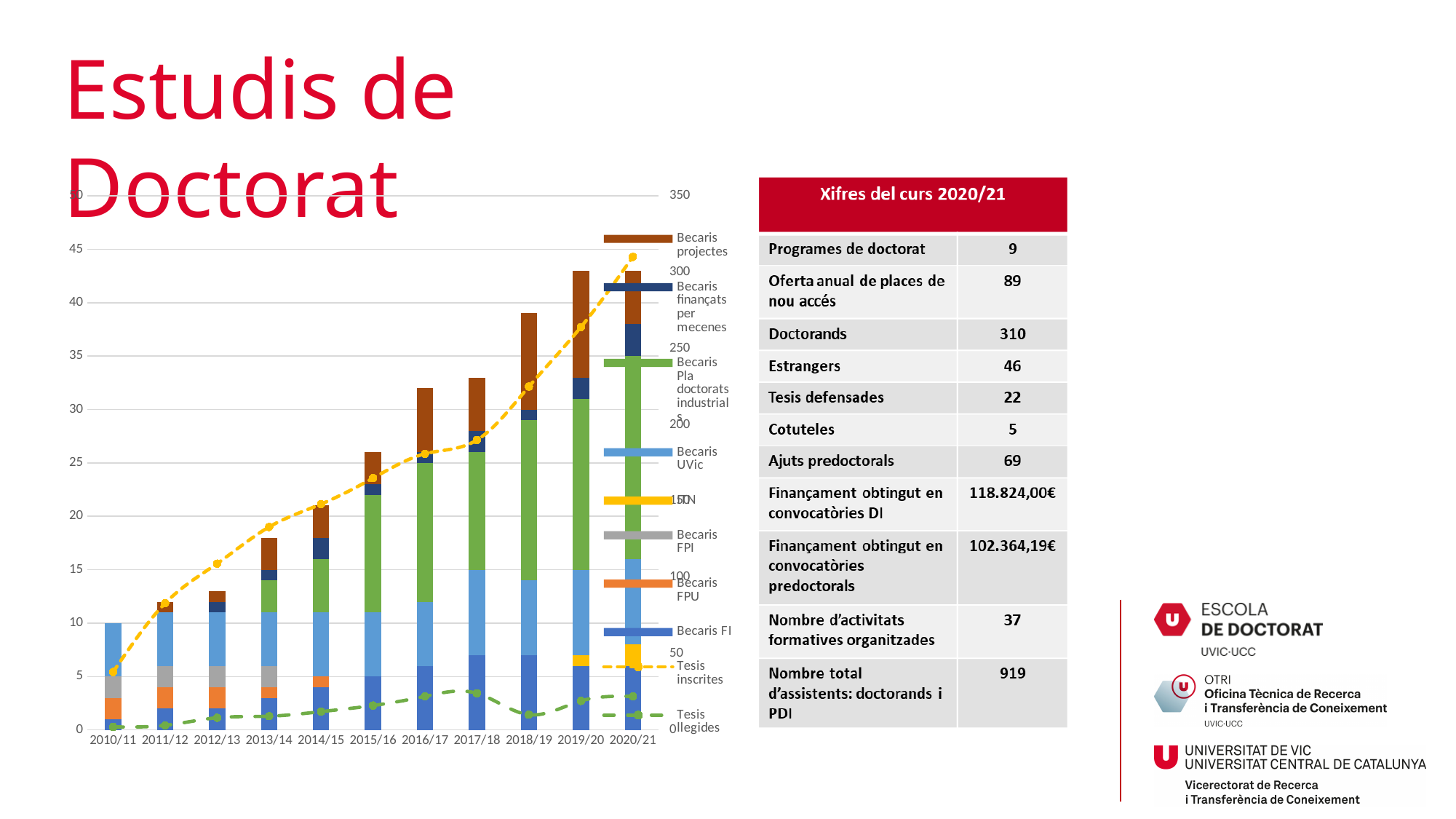
On the right-hand axis, is the 'Tesis llegides' value for 2020/21 greater or less than 50? less What kind of chart is shown on the left of the slide? stacked bar chart with line series Which academic year has the lowest total stacked bar? 2010/11 What colour represents 'Becaris UVic' in the chart legend? light blue Does the 'Tesis inscrites' line generally rise or fall from 2010/11 to 2020/21? rise How many academic years are shown along the x axis of the chart? 11 Is the total stacked bar for 2018/19 greater or less than 35? greater How many series does the chart legend list? 10 Which has the taller total stacked bar, 2013/14 or 2011/12? 2013/14 Which has the taller total stacked bar, 2018/19 or 2015/16? 2018/19 Is the total stacked bar for 2010/11 greater or less than 15? less